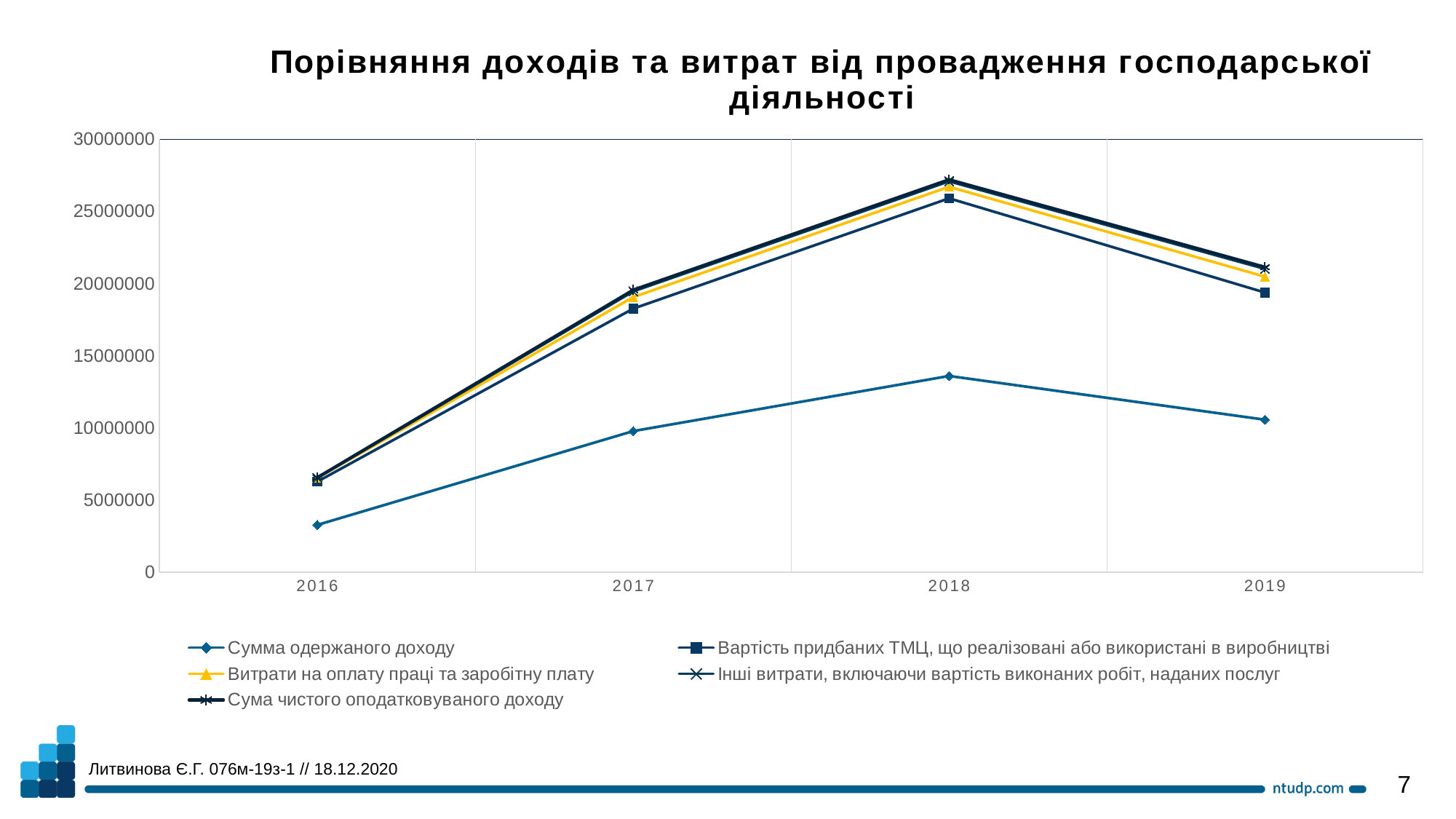
In which year is the value for "Сумма одержаного доходу" highest? 2018 Is the value for "Сумма одержаного доходу" in 2016 greater or less than 5000000? less Does the value for "Сумма одержаного доходу" rise or fall from 2018 to 2019? fall Is the value for "Сумма одержаного доходу" in 2018 greater or less than 10000000? greater What kind of chart is shown on the slide? line chart What colour is the line for "Витрати на оплату праці та заробітну плату"? yellow In which year is the value for "Сумма одержаного доходу" lowest? 2016 How many series does the chart's legend list? 5 Is the value for "Вартість придбаних ТМЦ, що реалізовані або використані в виробництві" in 2019 greater or less than 20000000? less How many years are shown on the x axis of the chart? 4